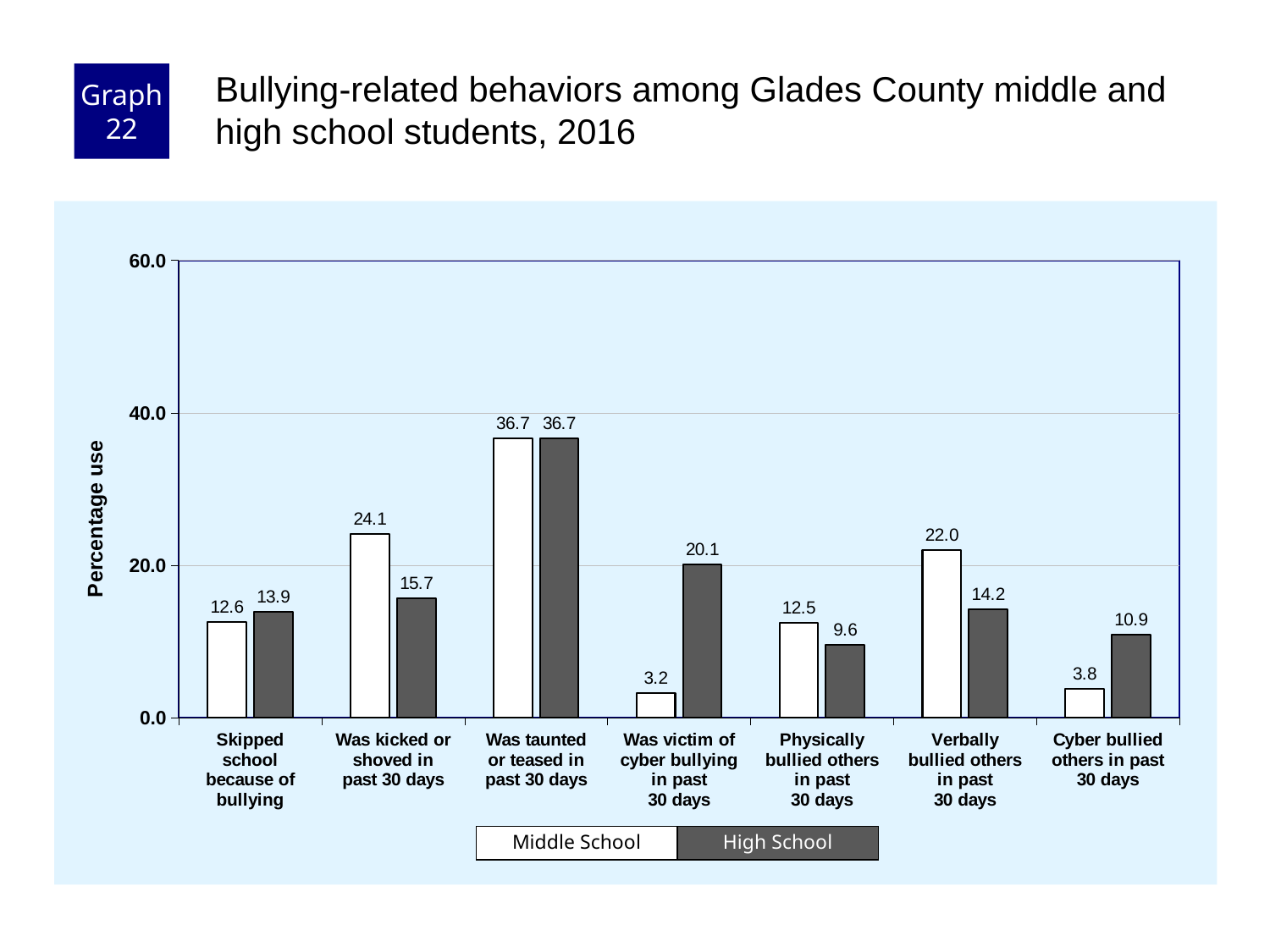
What is the Middle School value for 'Cyber bullied others in past 30 days'? 3.8 How many series does the legend list? 2 What is the Middle School value for 'Was kicked or shoved in past 30 days'? 24.1 For 'Physically bullied others in past 30 days', which is larger: the Middle School value or the High School value? Middle School Which category has the lowest Middle School value? Was victim of cyber bullying in past 30 days What is the difference between the Middle School and High School values for 'Verbally bullied others in past 30 days'? 7.8 How many categories are shown on the x axis? 7 Which category has the highest High School value? Was taunted or teased in past 30 days What is the label of the y axis? Percentage use Is the High School value for 'Was taunted or teased in past 30 days' greater or less than 20.0? greater What is the High School value for 'Was victim of cyber bullying in past 30 days'? 20.1 What kind of chart is shown on the slide? Bar chart